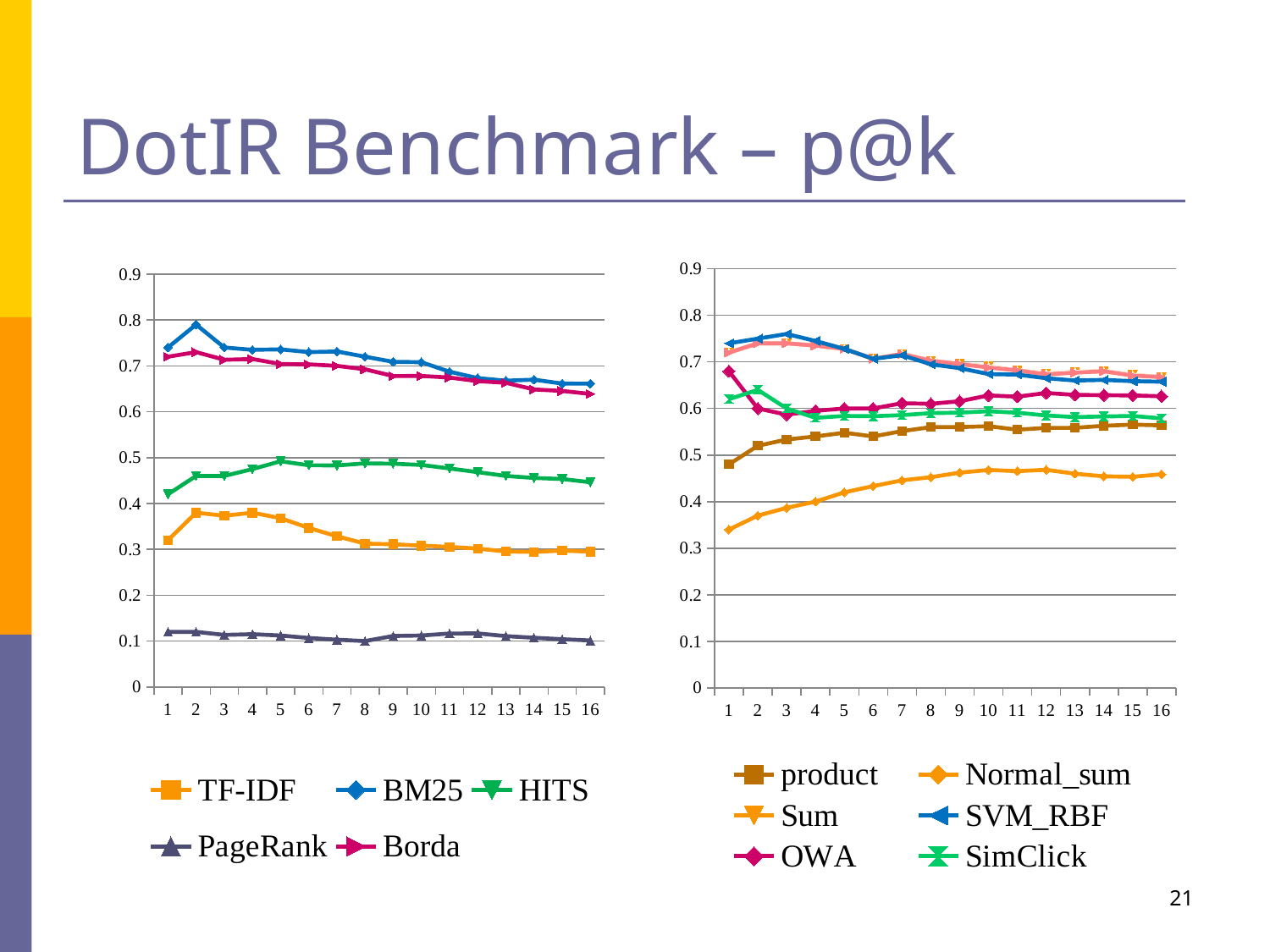
How many series does the legend of the left chart list? 5 How many points along the x axis does the left chart show? 16 In the left chart, which series has the highest value at x = 2? BM25 In the right chart, does the product series rise or fall from x = 1 to x = 16? rise In the left chart, is the value for HITS at x = 5 greater or less than 0.4? greater In the left chart, is the value for PageRank at x = 1 greater or less than 0.2? less In the left chart, does the TF-IDF series rise or fall from x = 4 to x = 16? fall In the right chart, is the value for Normal_sum at x = 1 greater or less than 0.4? less In the left chart, which series has the lowest values across the x axis? PageRank How many series does the legend of the right chart list? 6 In the right chart, which series has the lowest values across the x axis? Normal_sum What kind of chart is the left chart on the slide? line chart